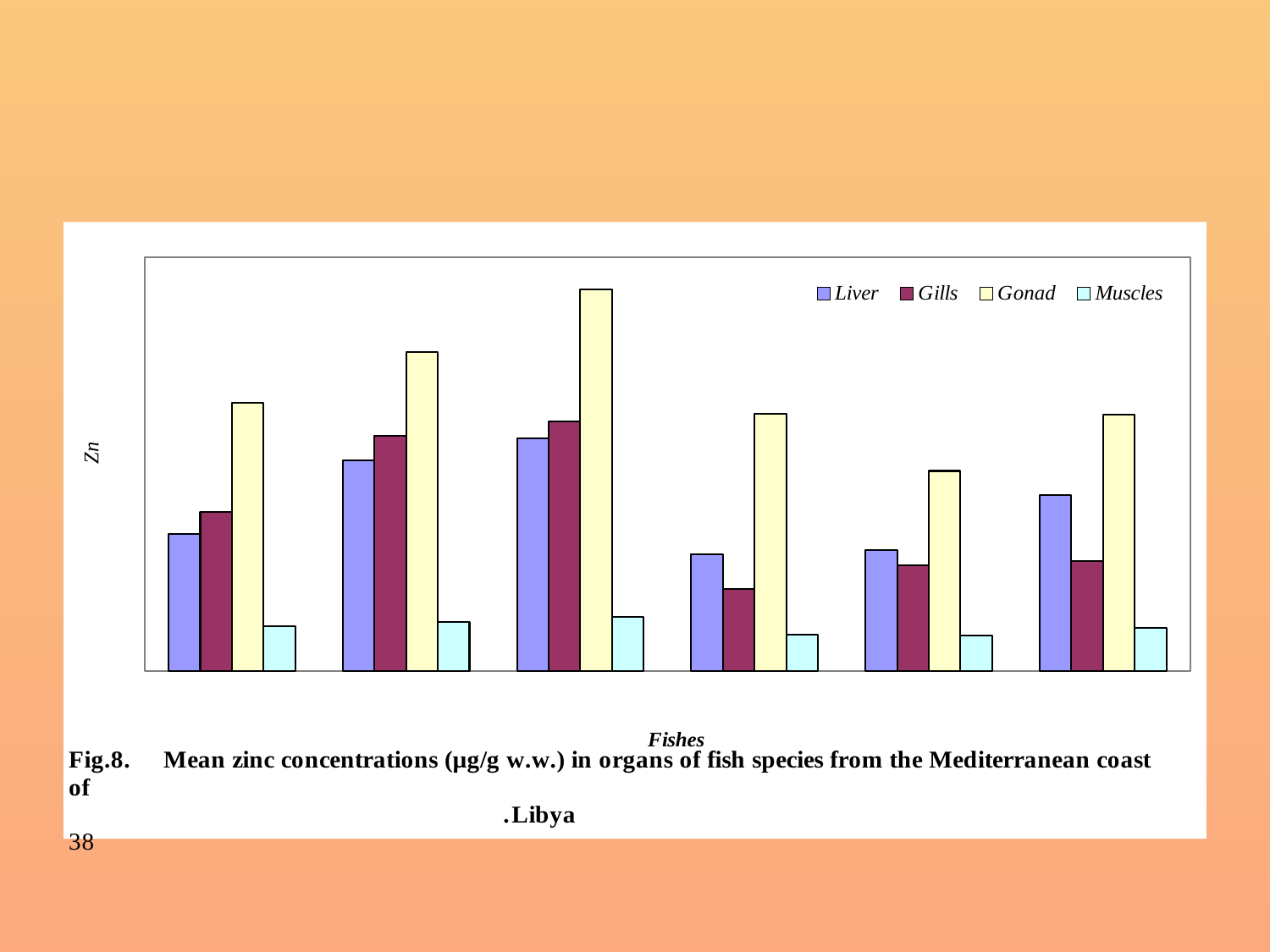
How many series does the legend list? 4 In the second group of bars from the left, is the Gills bar or the Liver bar taller? Gills What kind of chart is shown on the slide? bar chart What is the label on the vertical axis of the chart? Zn Which organ has the lowest zinc concentration in every fish group shown? Muscles Which organs are listed in the chart's legend? Liver, Gills, Gonad, Muscles In the third group of bars from the left, is the Gonad bar or the Liver bar taller? Gonad How many groups of bars (fish species) are plotted along the x axis? 6 In the first group of bars from the left, which organ has the highest zinc concentration? Gonad Across all six groups, which group has the tallest Gonad bar? the third group from the left In the fourth group of bars from the left, is the Liver bar or the Gills bar taller? Liver In the first group of bars from the left, which organ has the lowest zinc concentration? Muscles